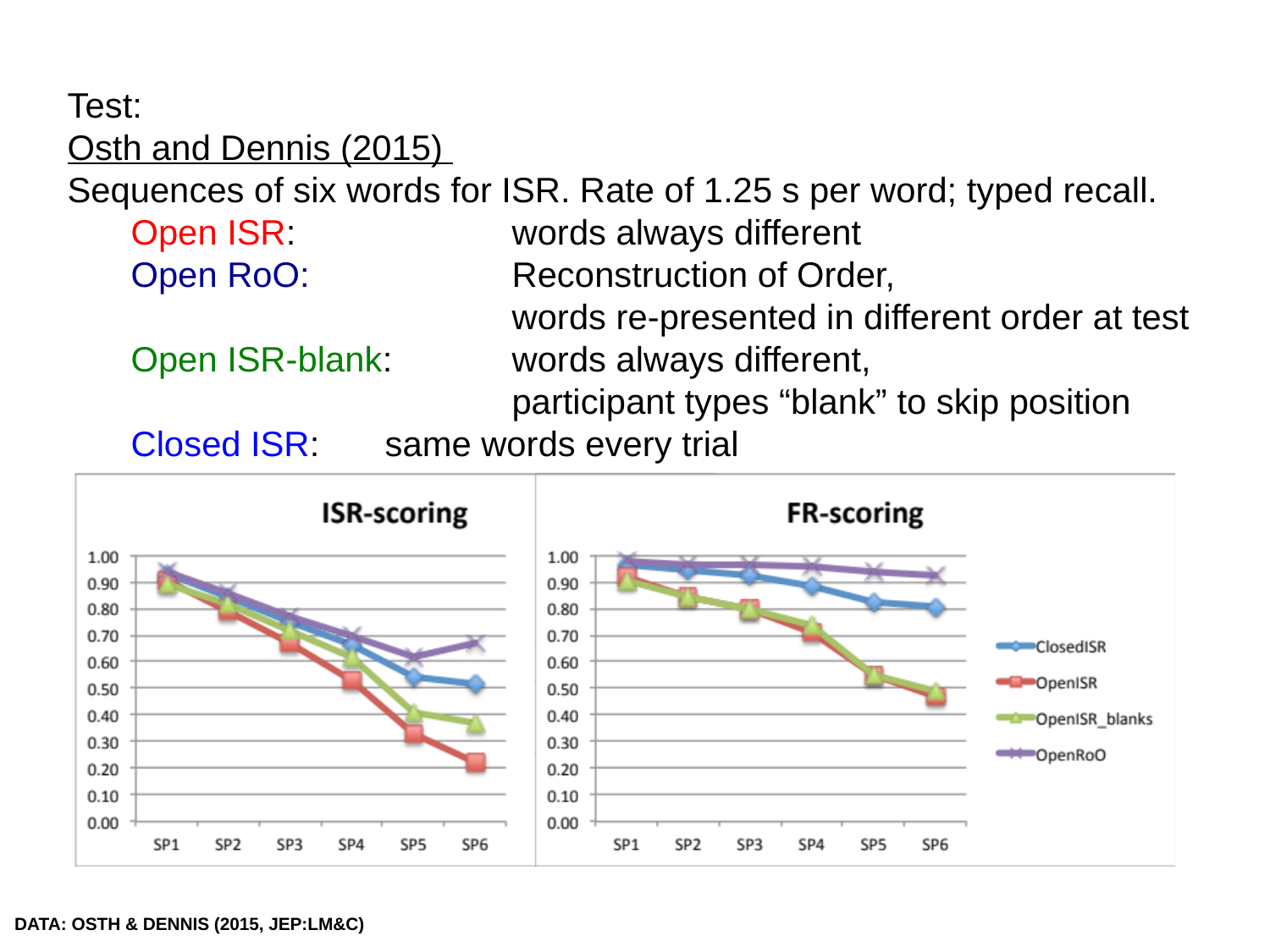
What type of chart is the ISR-scoring chart? line chart In the FR-scoring chart, is the value for OpenISR at SP6 greater or less than 0.60? less How many serial positions are shown on the x axis of the FR-scoring chart? 6 How many series does the legend list for the charts? 4 In the FR-scoring chart, which series has the highest value at SP6? OpenRoO In the ISR-scoring chart, at SP5, which is larger: OpenRoO or OpenISR? OpenRoO In the ISR-scoring chart, does the ClosedISR series rise or fall from SP1 to SP6? fall In the ISR-scoring chart, is the value for OpenRoO at SP6 greater or less than 0.60? greater In the FR-scoring chart, is the value for OpenRoO at SP6 greater or less than 0.90? greater In the ISR-scoring chart, which series has the highest value at SP6? OpenRoO In the ISR-scoring chart, which series has the lowest value at SP6? OpenISR